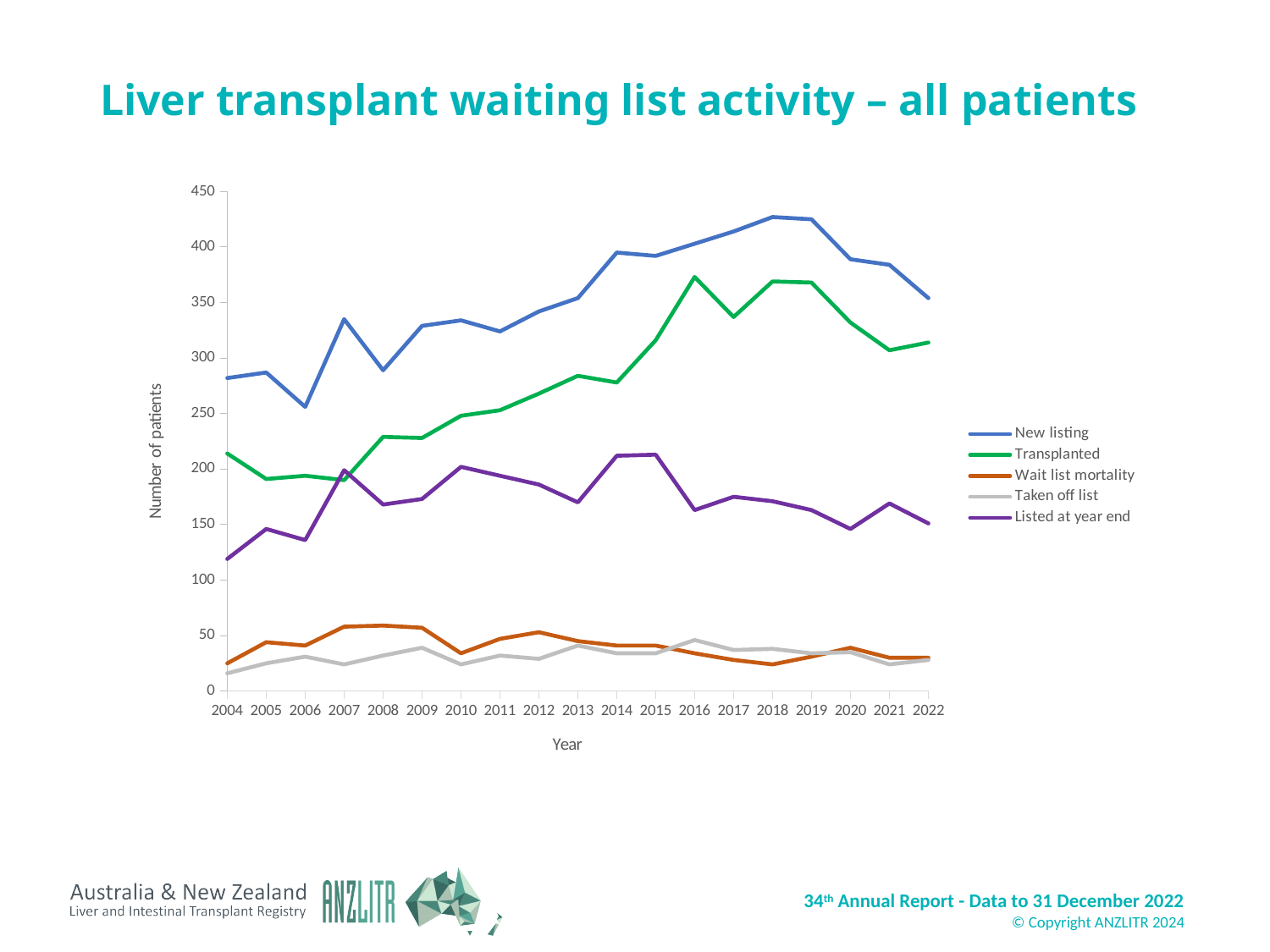
Does the Transplanted series generally rise or fall from 2004 to 2016? rise In 2022, which is larger: New listing or Transplanted? New listing Is the value for Transplanted in 2004 greater or less than 250? less How many years are plotted along the x axis? 19 How many series does the legend list? 5 What is the label on the y axis? Number of patients In which year is the Listed at year end series at its lowest? 2004 What kind of chart is shown on the slide? Line chart Is the value for New listing in 2018 greater or less than 400? greater In which year is the New listing series at its lowest? 2006 Is the value for Wait list mortality in 2007 greater or less than 50? greater Which series has the highest value on the chart overall? New listing